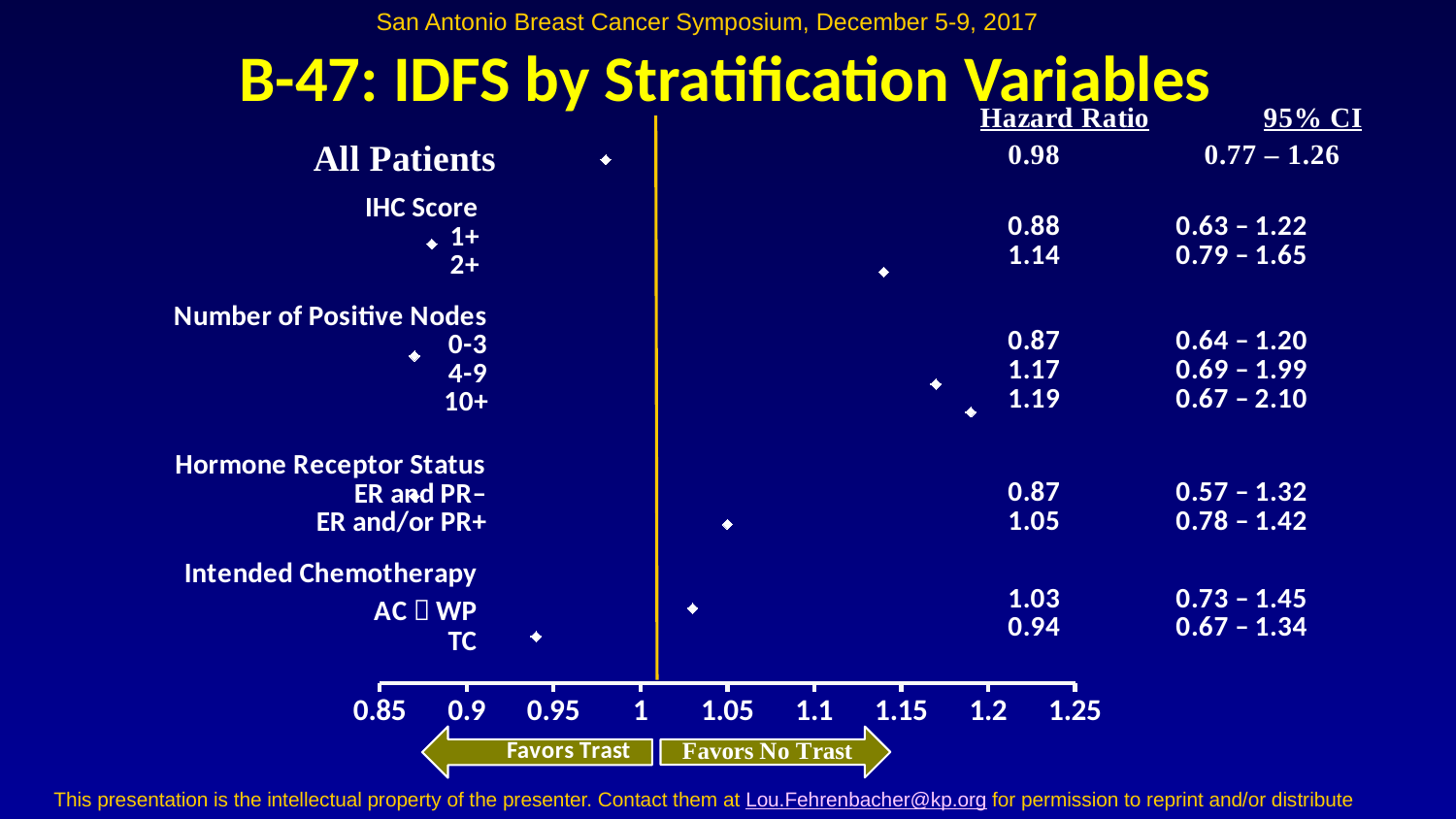
Is the hazard ratio for All Patients greater or less than 1? less What is the hazard ratio for the 10+ positive nodes subgroup? 1.19 Among the Number of Positive Nodes subgroups, which has the lowest hazard ratio? 0-3 What kind of chart is shown on the slide? Forest plot What is the difference between the hazard ratios for IHC Score 2+ and 1+? 0.26 What is the hazard ratio for All Patients? 0.98 What is the hazard ratio for the TC intended chemotherapy subgroup? 0.94 Which subgroup has the highest hazard ratio? 10+ positive nodes What does the left-pointing arrow below the x axis say? Favors Trast What is the 95% CI for the IHC Score 2+ subgroup? 0.79 – 1.65 How many subgroup hazard ratios are plotted below the All Patients row? 9 Which has the larger hazard ratio, the 4-9 nodes subgroup or the 0-3 nodes subgroup? 4-9